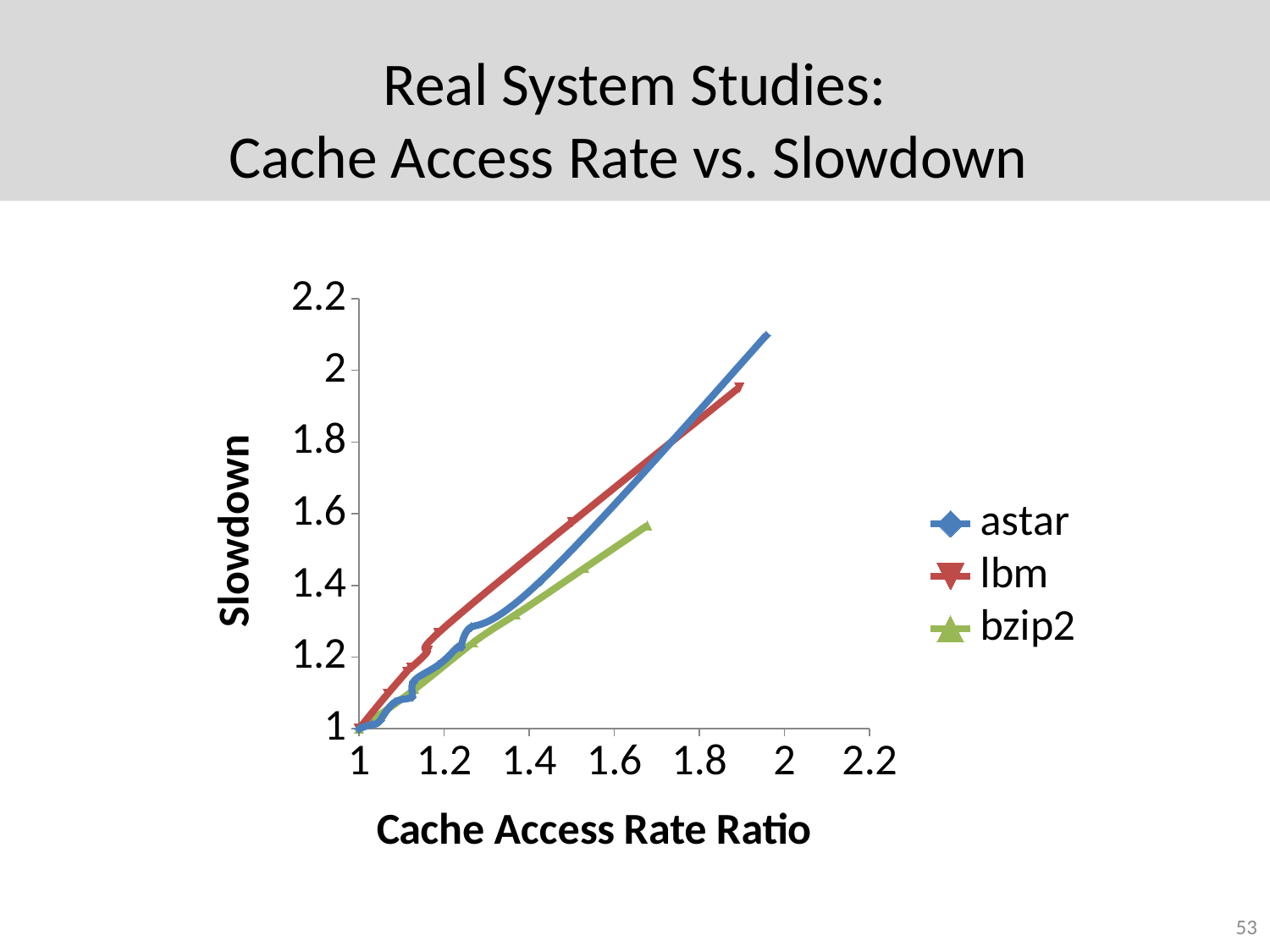
What type of chart is shown on the slide? line chart At the right end of the chart, which series has the larger slowdown, lbm or bzip2? lbm Is the highest slowdown reached by bzip2 greater or less than 1.4? greater Which series reaches the lowest maximum slowdown on the chart? bzip2 Does the slowdown for astar rise or fall as the cache access rate ratio increases? rise Which series reaches the highest slowdown on the chart? astar Is the highest slowdown reached by astar greater or less than 2? greater Which series are listed in the legend? astar, lbm, bzip2 How many series does the legend list? 3 Does the slowdown for bzip2 rise or fall as the cache access rate ratio increases? rise Is the highest slowdown reached by lbm greater or less than 2? less What is the label of the y axis? Slowdown